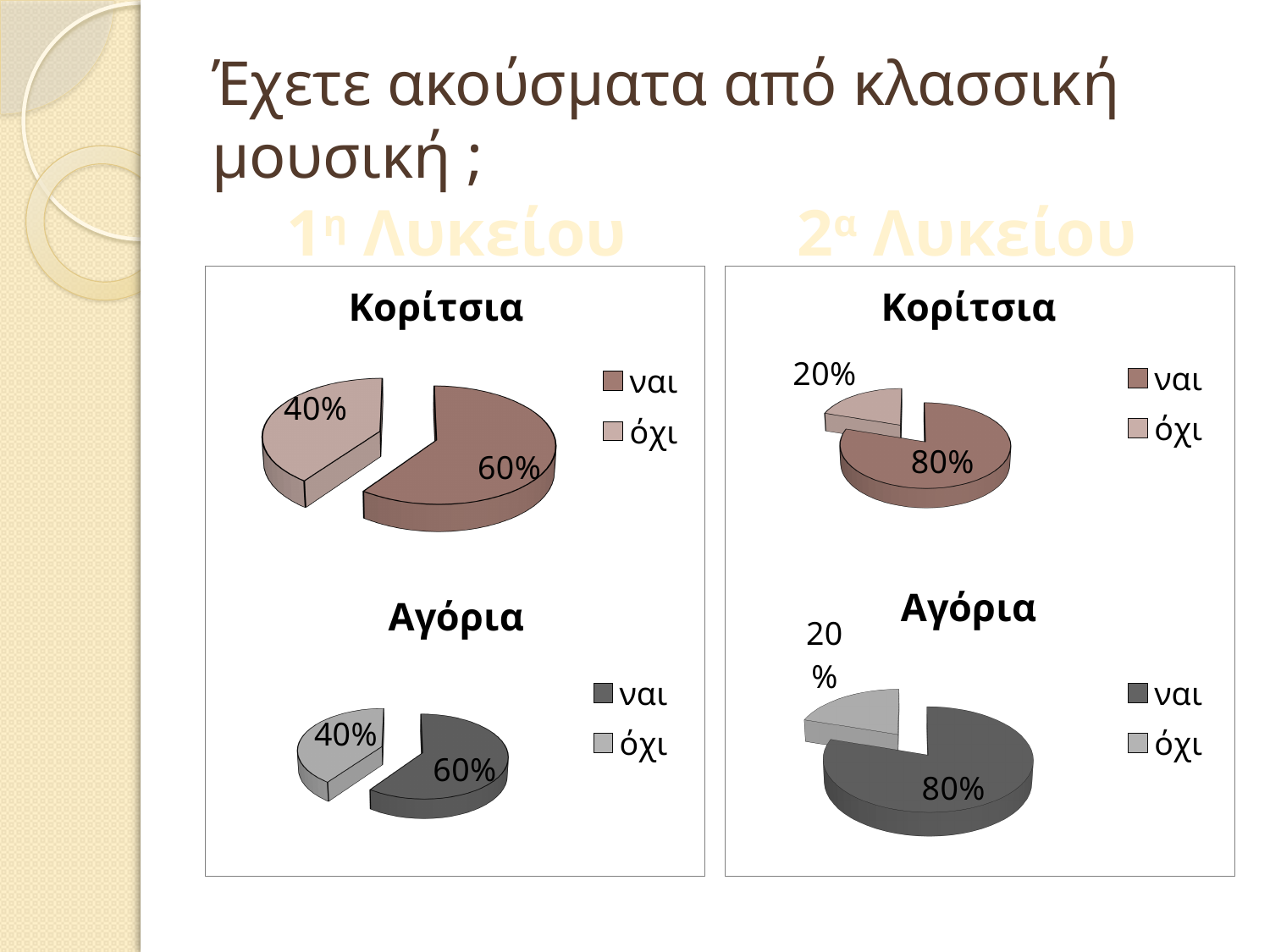
In the Κορίτσια chart on the right (2α Λυκείου), what share of the pie is ναι? 80% In the Αγόρια chart on the right (2α Λυκείου), what share of the pie is ναι? 80% In the Αγόρια chart on the left (1η Λυκείου), what is the value for όχι? 40% In the Αγόρια chart on the right (2α Λυκείου), which slice is the smallest? όχι In the Κορίτσια chart on the right (2α Λυκείου), what is the difference between the ναι and όχι shares? 60% In the Κορίτσια chart on the left (1η Λυκείου), which slice is larger, ναι or όχι? ναι In the Κορίτσια chart on the right (2α Λυκείου), what is the value for όχι? 20% How many entries does the legend of the Κορίτσια chart on the right (2α Λυκείου) list? 2 What kind of chart is the Αγόρια chart on the left (1η Λυκείου)? Pie chart In the Κορίτσια chart on the left (1η Λυκείου), what share of the pie is όχι? 40% In the Αγόρια chart on the left (1η Λυκείου), what is the value for ναι? 60%